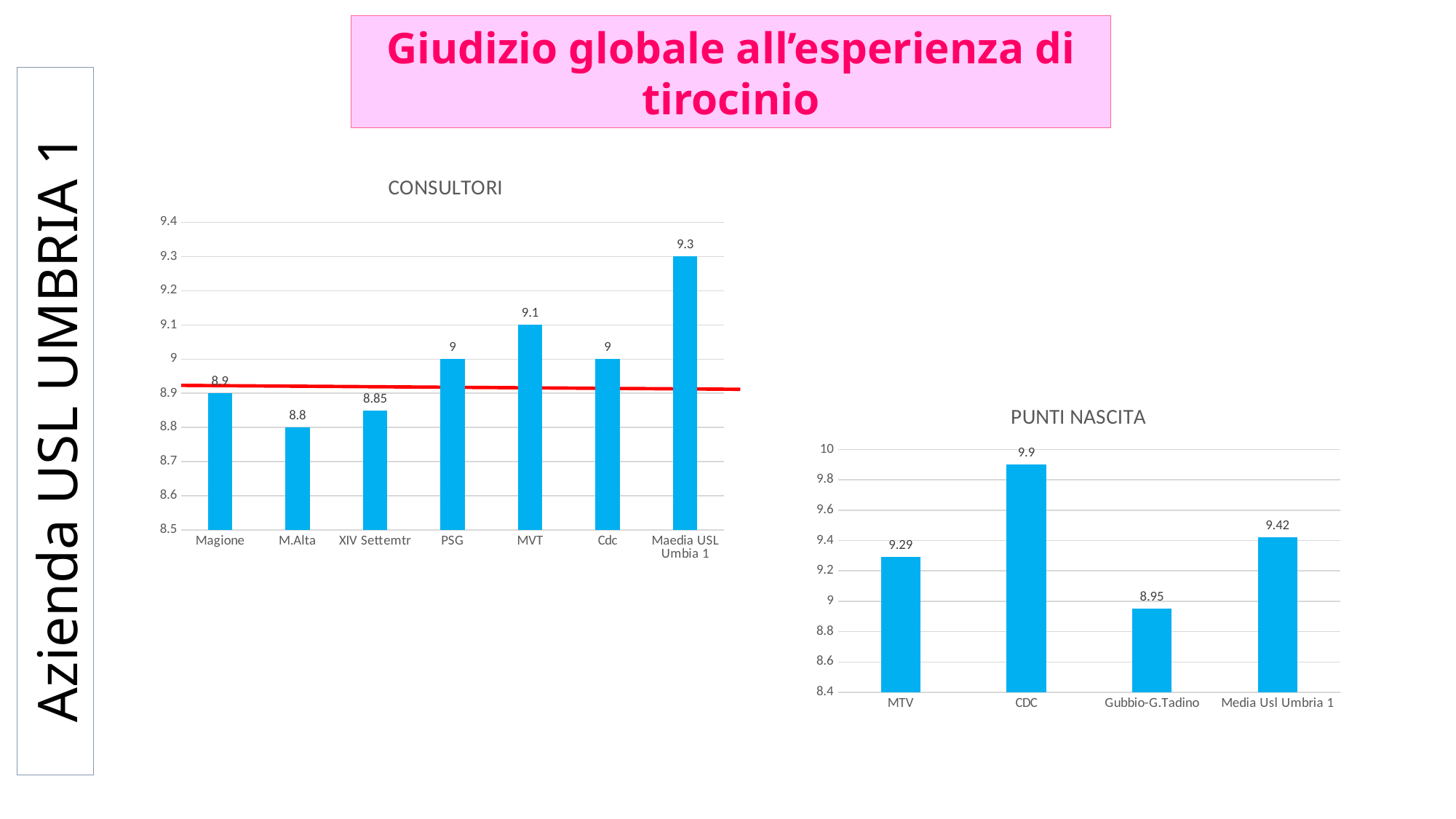
In the CONSULTORI chart, what is the difference between the values for Maedia USL Umbia 1 and Magione? 0.4 In the CONSULTORI chart, what is the value for XIV Settemtr? 8.85 What kind of chart is the PUNTI NASCITA chart? Bar chart In the CONSULTORI chart, what is the value for MVT? 9.1 In the PUNTI NASCITA chart, which is larger, the value for MTV or the value for Gubbio-G.Tadino? MTV In the CONSULTORI chart, how many categories are shown on the x axis? 7 In the PUNTI NASCITA chart, what is the value for Media Usl Umbria 1? 9.42 In the CONSULTORI chart, which category has the lowest value? M.Alta In the PUNTI NASCITA chart, what is the difference between the values for CDC and MTV? 0.61 In the PUNTI NASCITA chart, what is the value for Gubbio-G.Tadino? 8.95 In the PUNTI NASCITA chart, which category has the highest value? CDC In the CONSULTORI chart, which category has the highest value? Maedia USL Umbia 1